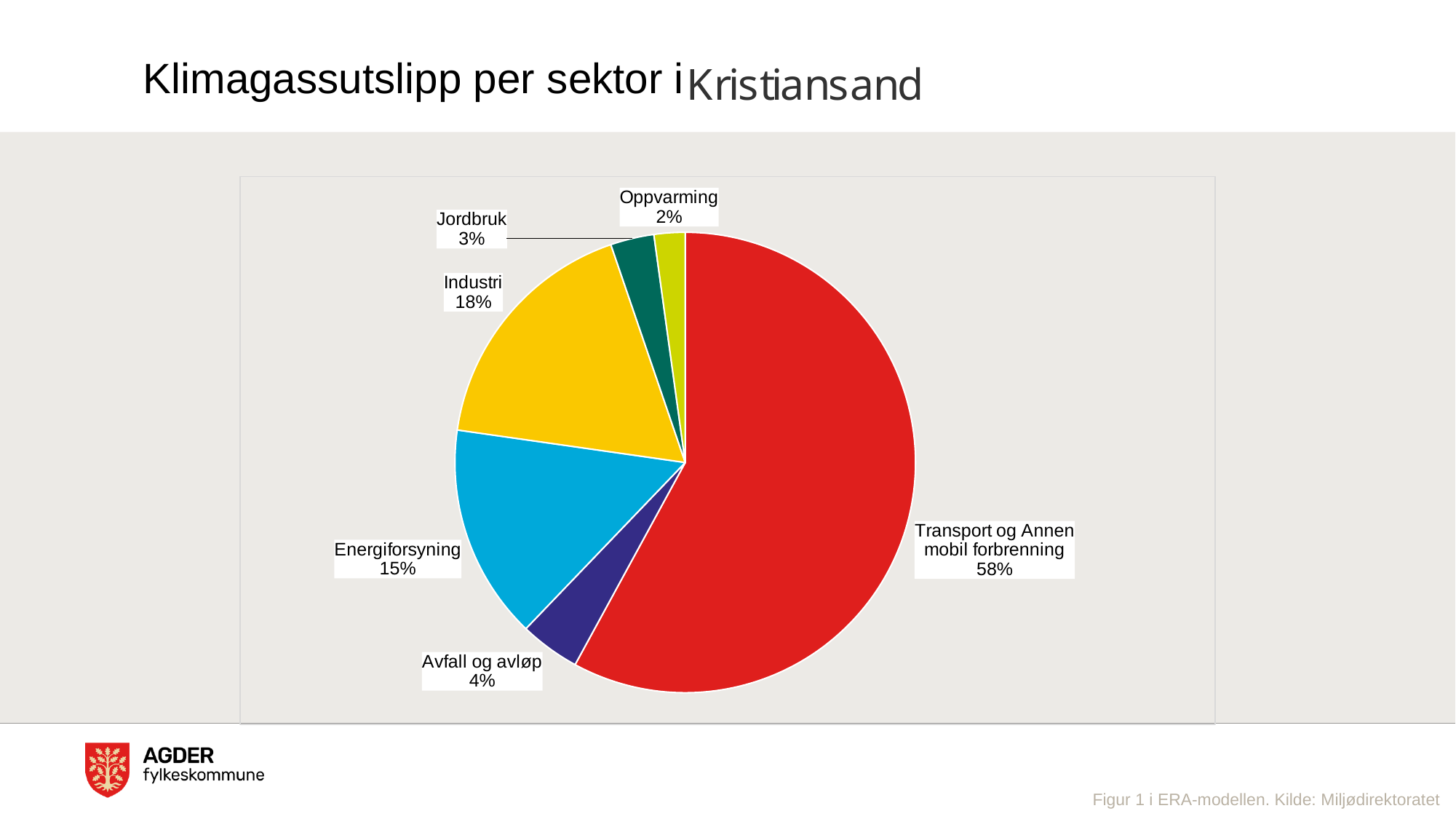
Which sector has the largest share of the pie? Transport og Annen mobil forbrenning What is the value shown for Industri? 18% What is the value shown for Energiforsyning? 15% What is the value shown for Jordbruk? 3% Which sector has the smallest share of the pie? Oppvarming Which is larger, the share for Avfall og avløp or the share for Jordbruk? Avfall og avløp What share of the pie does Transport og Annen mobil forbrenning have? 58% What kind of chart is shown on the slide? Pie chart How many sectors are shown in the pie chart? 6 What is the difference in percentage points between Industri and Energiforsyning? 3 What is the value shown for Avfall og avløp? 4% What is the title of the slide? Klimagassutslipp per sektor i Kristiansand